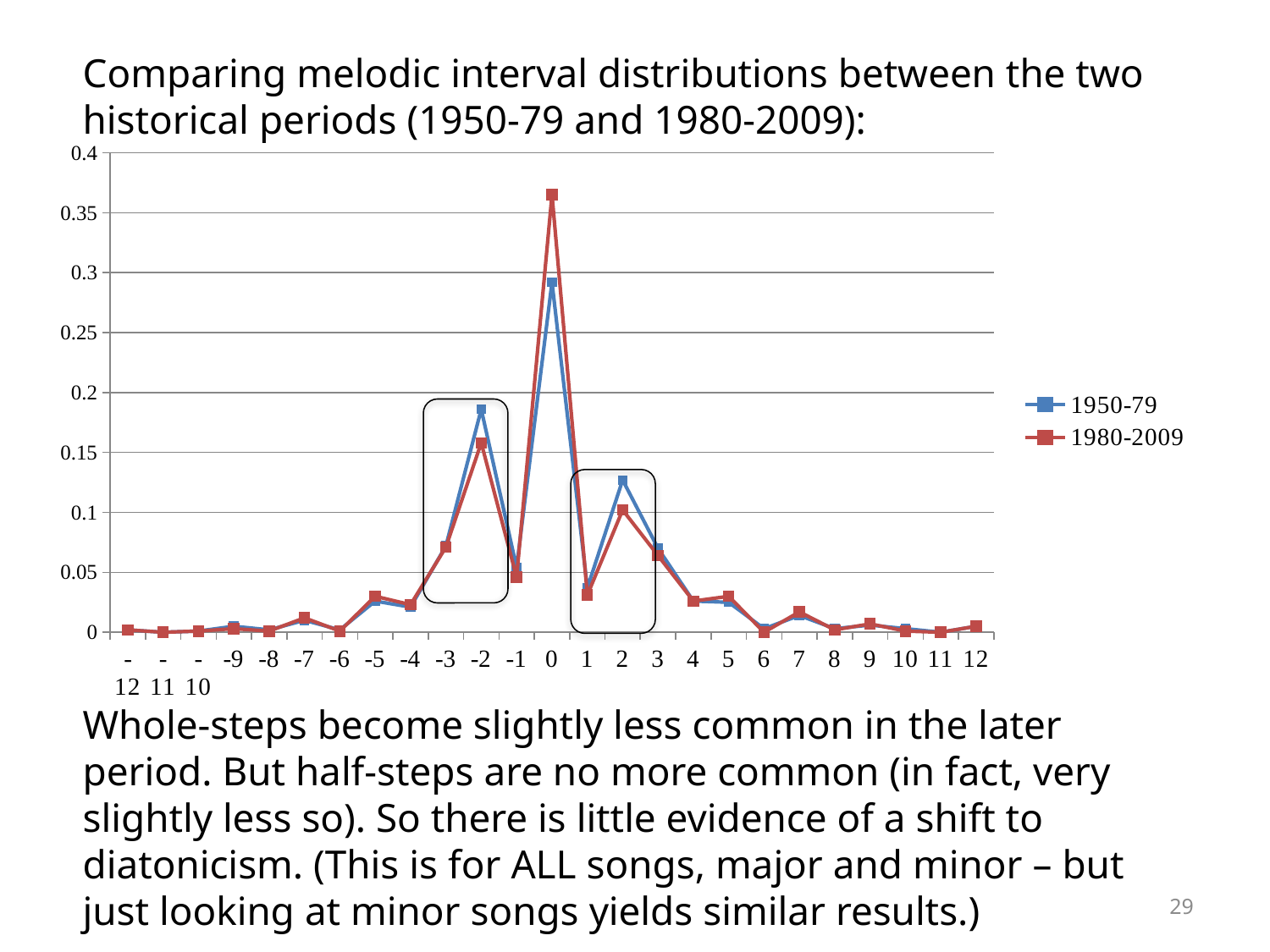
At interval 0, which series has the larger value, 1950-79 or 1980-2009? 1980-2009 How many interval categories are shown along the x axis? 25 What are the two series named in the legend? 1950-79 and 1980-2009 At interval -2, which series has the larger value, 1950-79 or 1980-2009? 1950-79 What kind of chart is shown on the slide? line chart At interval 2, which series has the larger value, 1950-79 or 1980-2009? 1950-79 Is the value for the 1950-79 series at interval 0 greater or less than 0.3? less At which interval does the 1950-79 series reach its highest value? 0 Do the values of the 1980-2009 series generally rise or fall as the interval goes from 0 to 12? fall Is the value for the 1980-2009 series at interval 0 greater or less than 0.35? greater How many series does the legend list? 2 At which interval does the 1980-2009 series reach its highest value? 0